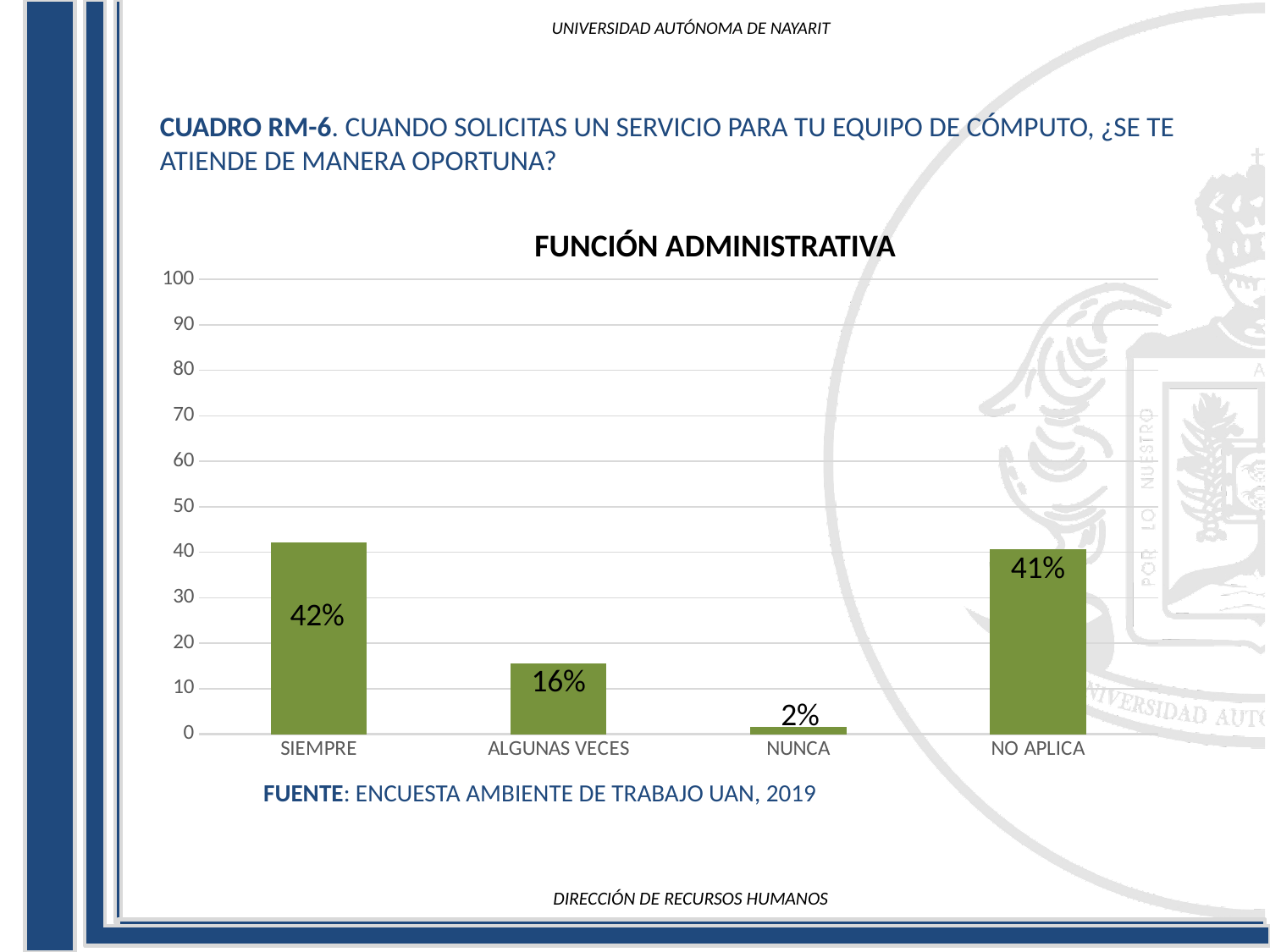
How many categories are shown on the x axis? 4 Is the value for SIEMPRE greater or less than 30? greater Which category has the lowest value? NUNCA What is the title of the chart? FUNCIÓN ADMINISTRATIVA What is the value for NO APLICA? 41% What kind of chart is shown? bar chart What is the difference between the values for NO APLICA and NUNCA? 39% What is the value for ALGUNAS VECES? 16% What is the difference between the values for SIEMPRE and ALGUNAS VECES? 26% What is the value for SIEMPRE? 42% What is the value for NUNCA? 2% Which is larger, the value for ALGUNAS VECES or the value for NO APLICA? NO APLICA